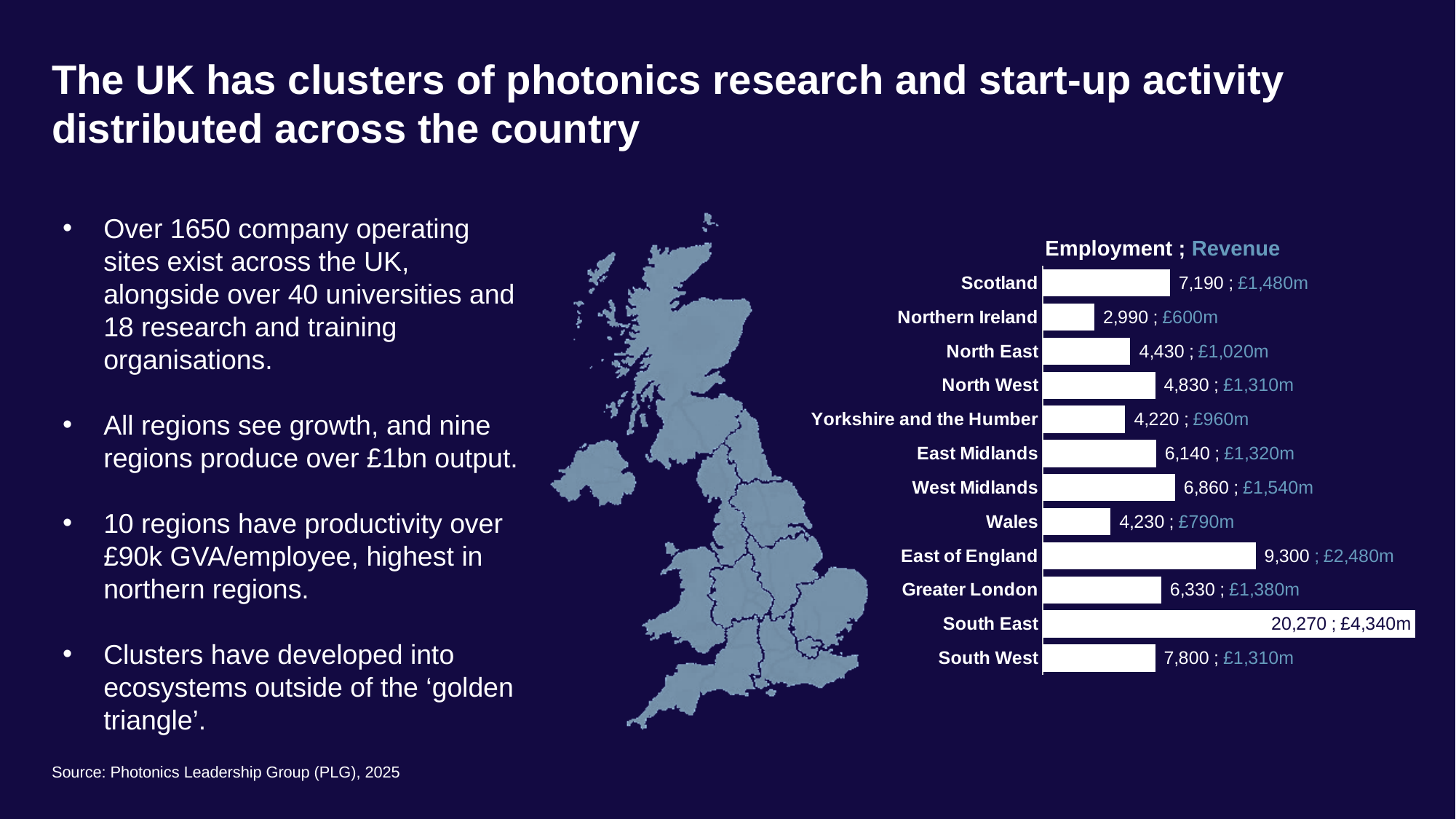
What revenue is shown for East of England? £2,480m What two measures does the chart heading say are shown for each region? Employment ; Revenue Which region has the highest employment? South East What kind of chart is shown on the slide? Bar chart What revenue is shown for Greater London? £1,380m What is the difference in revenue between Scotland and Northern Ireland? £880m How many regions are shown in the chart? 12 What is the difference in employment between South East and East of England? 10,970 Which has higher employment, West Midlands or East Midlands? West Midlands What is the employment figure shown for Wales? 4,230 What is the employment figure shown for Scotland? 7,190 Which region has the lowest employment? Northern Ireland